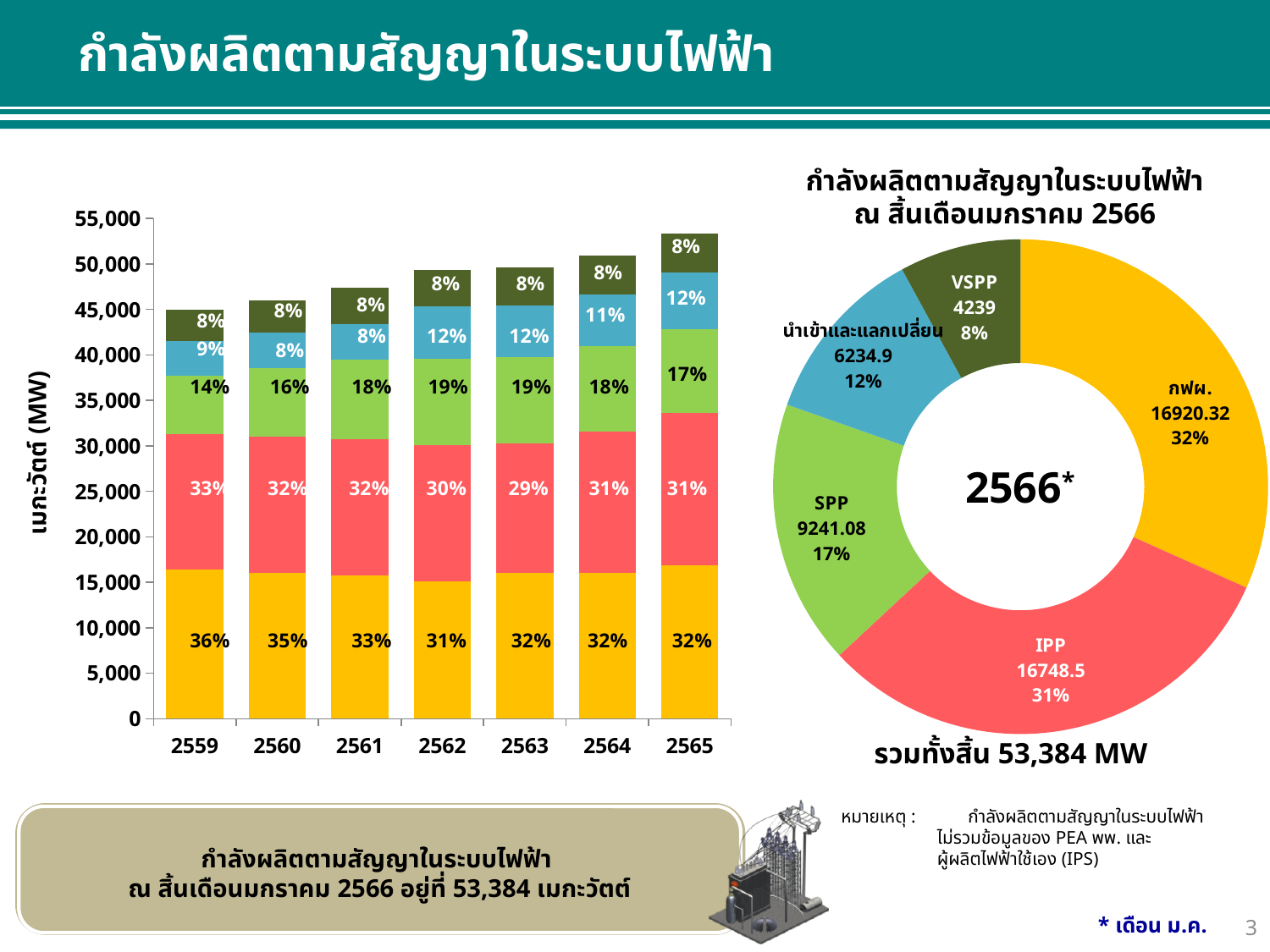
How many years are shown on the x axis of the bar chart on the left? 7 What kind of chart is the chart on the left of the slide? stacked bar chart In the bar chart on the left, what percentage label is shown on the bottom (yellow) segment for 2559? 36% In the donut chart on the right, what share does SPP have? 17% In the donut chart on the right, what is the value for IPP? 16748.5 What kind of chart is the chart on the right titled กำลังผลิตตามสัญญาในระบบไฟฟ้า ณ สิ้นเดือนมกราคม 2566? donut (pie) chart In the donut chart on the right, which category has the smallest share? VSPP In the donut chart on the right, which category has the largest share? กฟผ. In the bar chart on the left, is the total height of the 2565 bar greater or less than 50,000? greater In the bar chart on the left, does the percentage of the bottom (yellow) segment rise or fall from 2559 to 2565? fall In the bar chart on the left, what percentage label is shown on the green segment for 2562? 19% In the donut chart on the right, what is the difference between the values for กฟผ. and IPP? 171.82